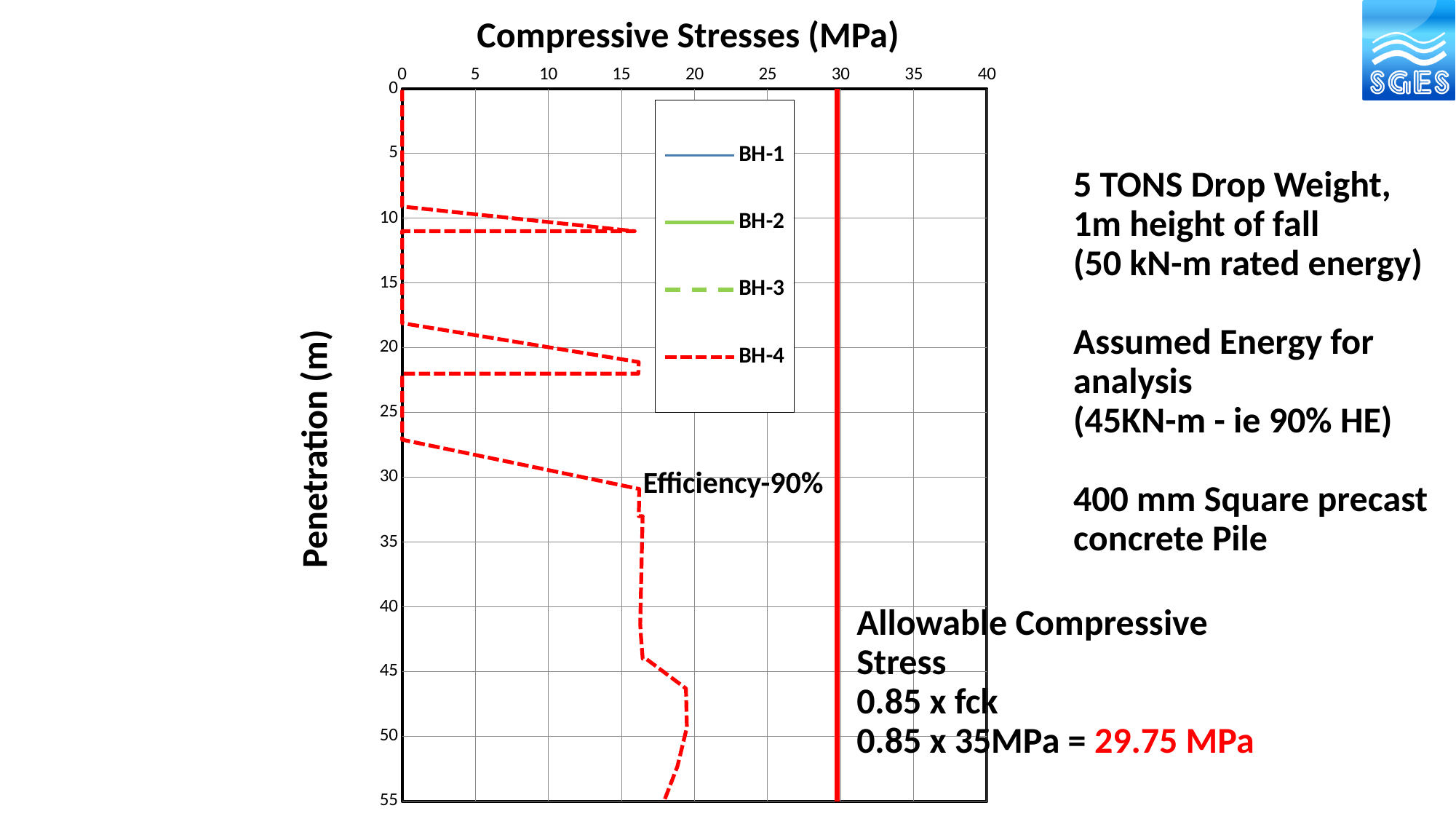
What is the title of the horizontal axis of the chart? Compressive Stresses (MPa) Is the peak compressive stress for BH-4 near 11 m penetration greater or less than 20 MPa? less How many series does the chart legend list? 4 What efficiency is stated in the label inside the chart area? Efficiency-90% What kind of chart is shown on the slide? line chart Is the compressive stress for BH-4 at a penetration of 5 m greater or less than 5 MPa? less Is the compressive stress for BH-4 at a penetration of 50 m greater or less than 15 MPa? greater What allowable compressive stress value is marked by the solid red vertical line on the chart? 29.75 MPa What is the title of the vertical axis of the chart? Penetration (m) Which is larger at a penetration of 50 m: the BH-4 compressive stress or the allowable compressive stress line? the allowable compressive stress line What is the largest value shown on the horizontal (Compressive Stresses) axis? 40